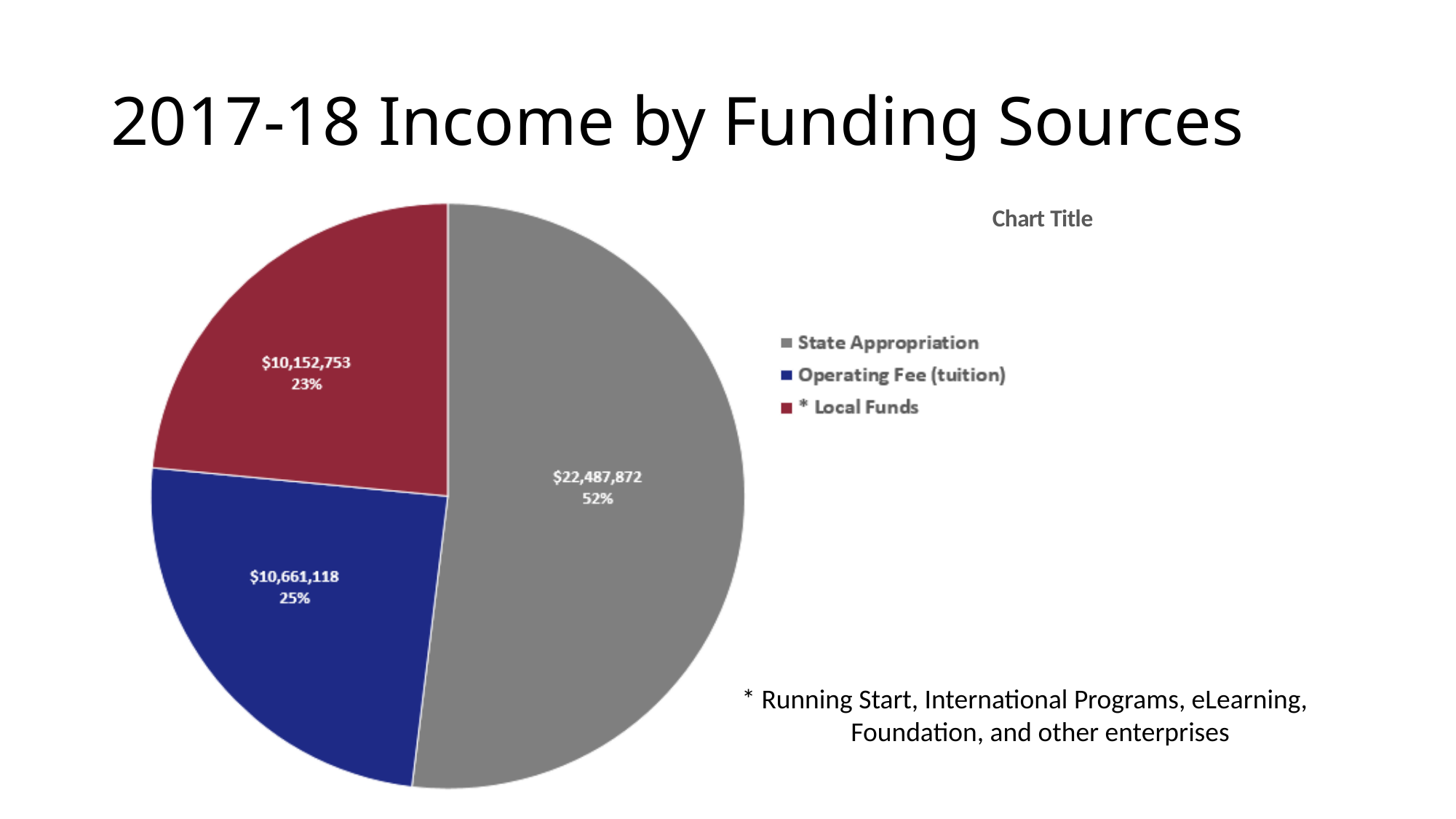
What share of the pie does State Appropriation represent? 52% How many slices does the pie chart have? 3 What share of the pie does * Local Funds represent? 23% What is the value for * Local Funds? $10,152,753 Which funding source is the smallest? * Local Funds What colour is the State Appropriation slice? Grey What is the value for State Appropriation? $22,487,872 What is the value for Operating Fee (tuition)? $10,661,118 Which funding source is the largest? State Appropriation What is the difference between State Appropriation and Operating Fee (tuition)? $11,826,754 Which is larger, Operating Fee (tuition) or * Local Funds? Operating Fee (tuition) What kind of chart is shown on the slide? Pie chart